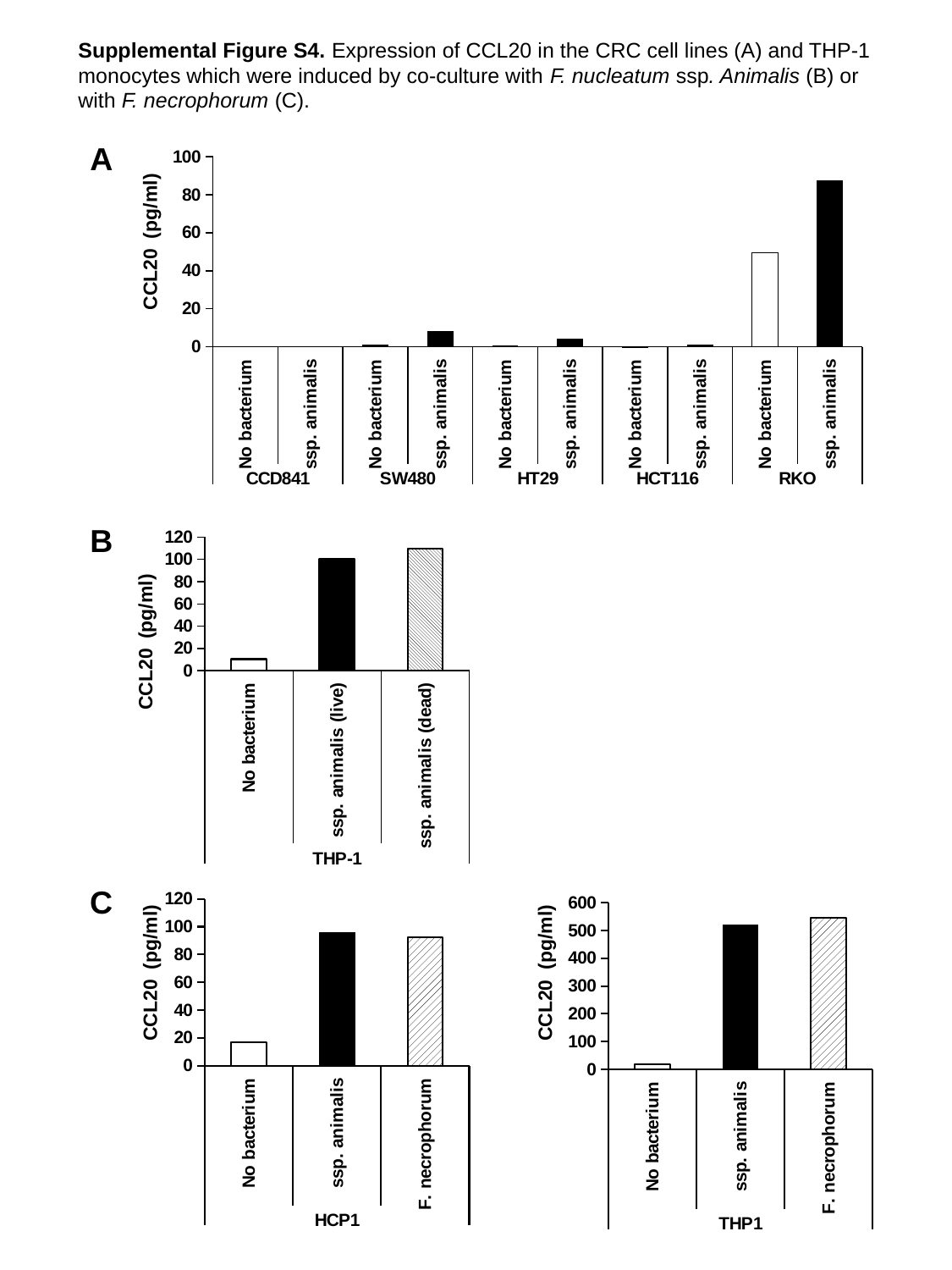
In chart A, is the value for RKO with ssp. animalis greater or less than 80? greater In chart A, is the value for RKO with No bacterium greater or less than 60? less In the left chart of panel C (HCP1), is the value for ssp. animalis greater or less than 80? greater In chart B, how many bars are plotted? 3 In chart A (CRC cell lines), which bar is the highest? RKO, ssp. animalis In chart A, how many cell lines are shown along the x axis? 5 In the right chart of panel C (THP1), which bar is the lowest? No bacterium In chart B (THP-1), which bar is the lowest? No bacterium In chart A, which is larger for RKO: No bacterium or ssp. animalis? ssp. animalis What kind of chart is used in panel A? Bar chart